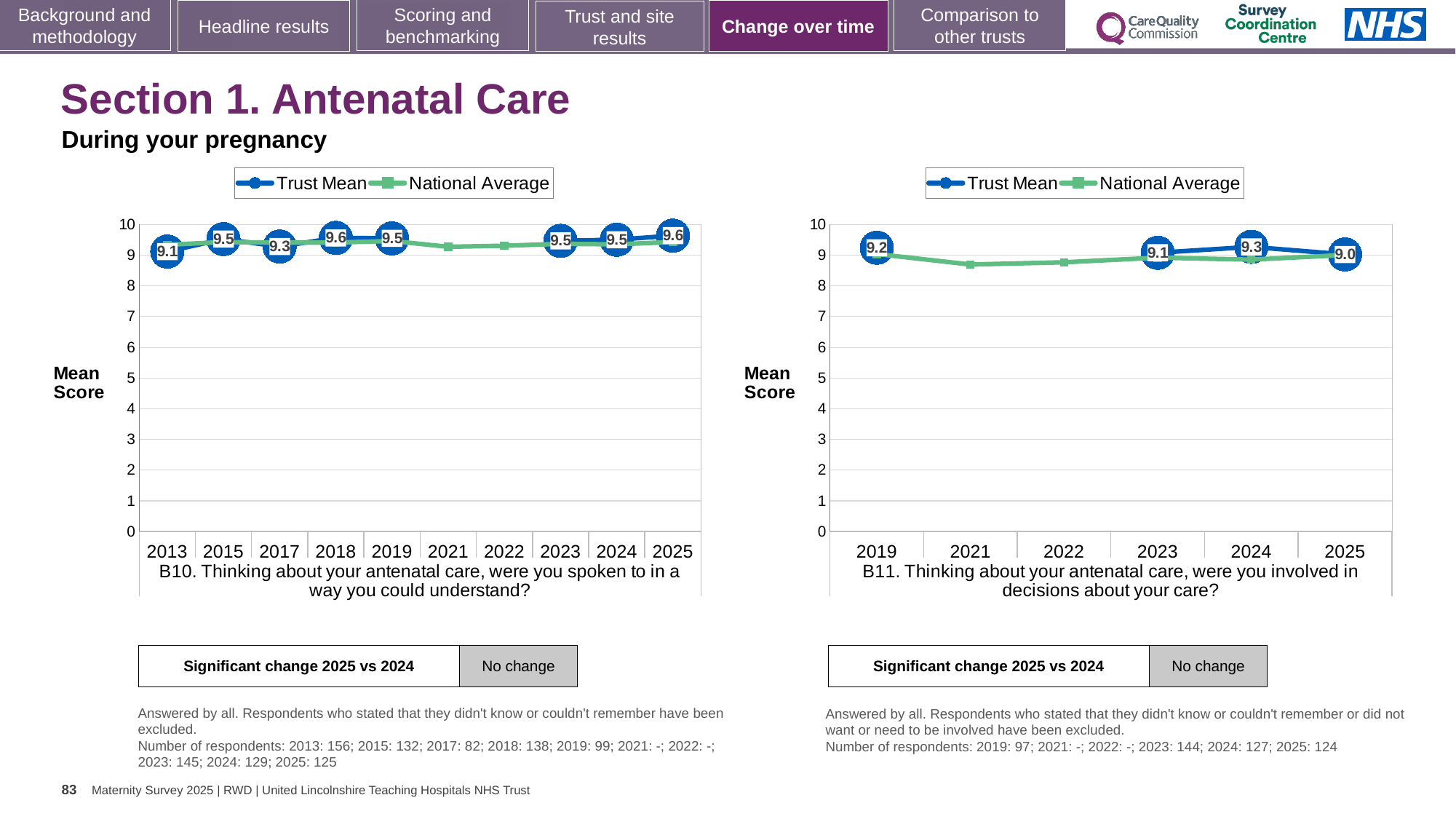
In the B11 chart on the right, what is the Trust Mean for 2024? 9.3 In the B11 chart on the right, which year has the highest Trust Mean? 2024 In the B11 chart on the right, is the Trust Mean for 2024 or for 2025 larger? 2024 In the B10 chart on the left, what is the Trust Mean for 2013? 9.1 In the B10 chart on the left, what is the difference between the Trust Mean for 2025 and for 2013? 0.5 In the B11 chart on the right, is the National Average for 2021 greater or less than 9? less In the B10 chart on the left, what is the Trust Mean for 2025? 9.6 What kind of chart is the B10 chart on the left? Line chart How many years are shown on the x axis of the B11 chart on the right? 6 In the B10 chart on the left, which year has the lowest Trust Mean? 2013 In the B11 chart on the right, which year has the lowest Trust Mean? 2025 How many series does the legend of the B10 chart on the left list? 2